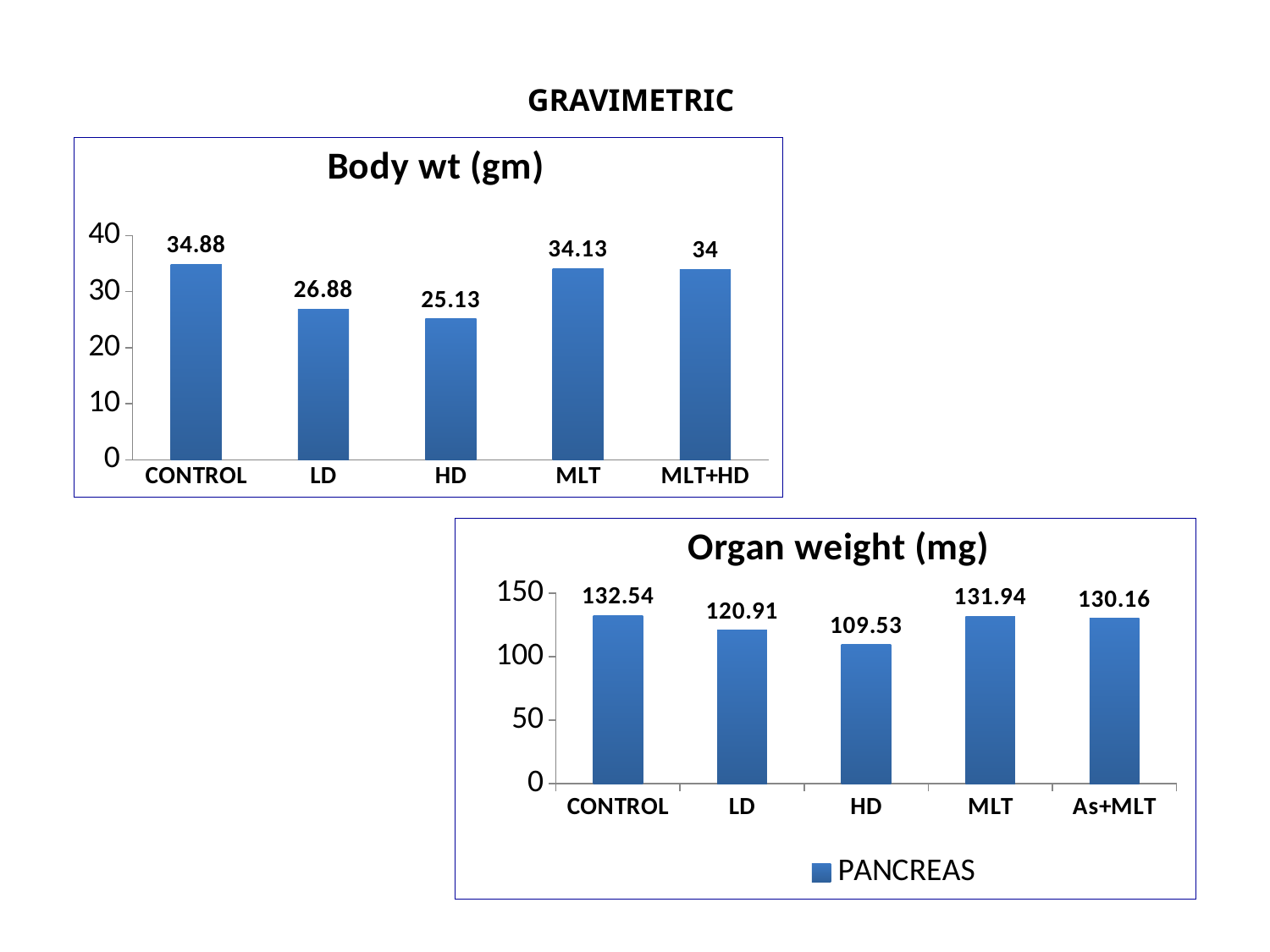
In the 'Body wt (gm)' chart, which category has the lowest value? HD What kind of chart is the 'Body wt (gm)' chart? Bar chart In the 'Body wt (gm)' chart, how many categories are shown on the x axis? 5 In the 'Organ weight (mg)' chart, what is the difference between CONTROL and HD? 23.01 In the 'Organ weight (mg)' chart, what series does the legend list? PANCREAS In the 'Organ weight (mg)' chart, what is the value for As+MLT? 130.16 In the 'Organ weight (mg)' chart, which is larger, the value for LD or the value for HD? LD In the 'Body wt (gm)' chart, what is the value for CONTROL? 34.88 In the 'Organ weight (mg)' chart, what is the value for LD? 120.91 In the 'Body wt (gm)' chart, what is the difference between CONTROL and LD? 8 In the 'Body wt (gm)' chart, what is the value for HD? 25.13 In the 'Organ weight (mg)' chart, which category has the highest value? CONTROL